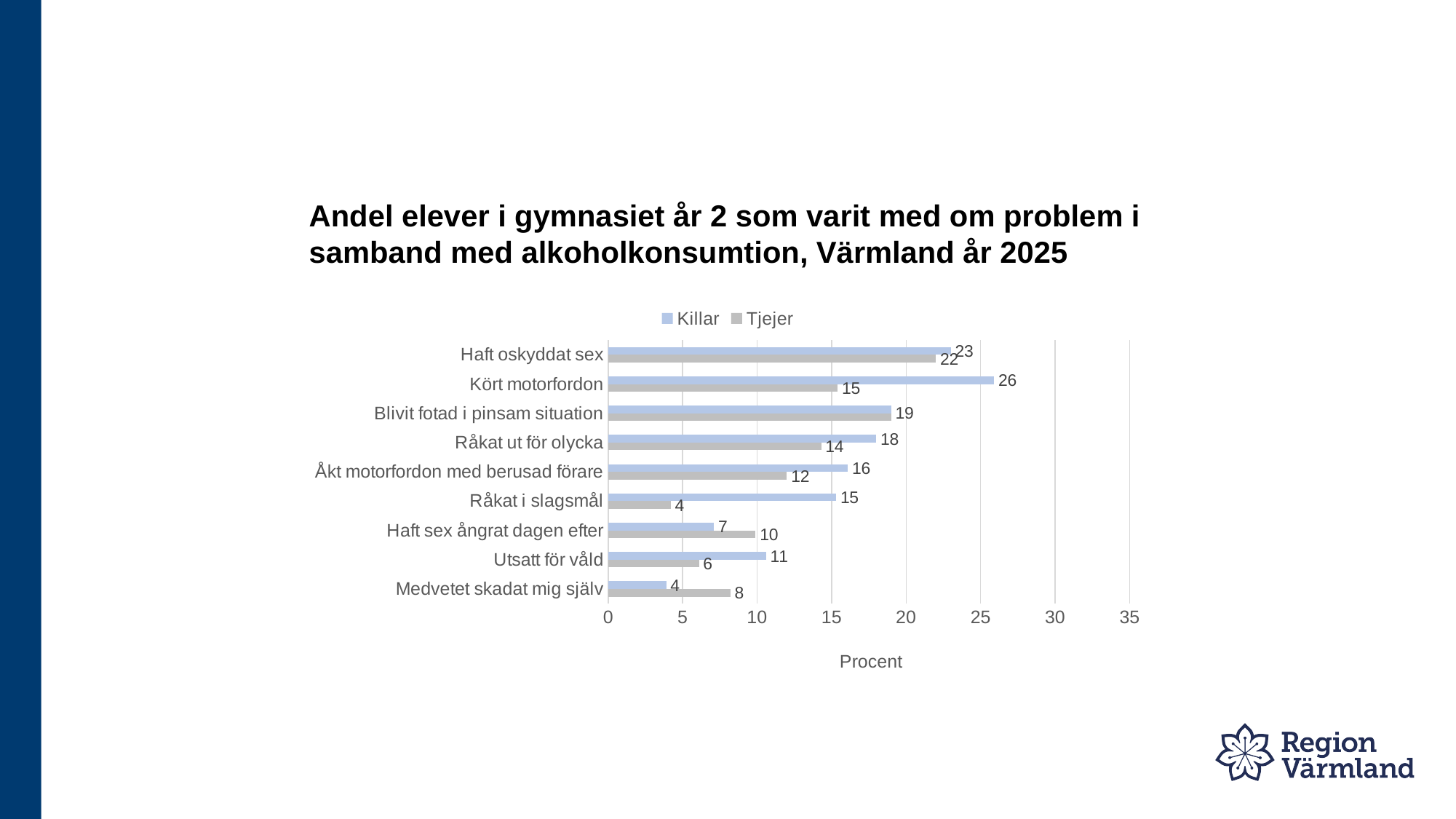
What is the label of the horizontal axis? Procent Which category has the lowest value for Killar? Medvetet skadat mig själv How many series does the legend list? 2 Which category has the highest value for Tjejer? Haft oskyddat sex How many categories are shown on the chart? 9 What is the value for Tjejer for 'Råkat i slagsmål'? 4 What is the value for Tjejer for 'Haft oskyddat sex'? 22 For 'Haft sex ångrat dagen efter', which is larger, Killar or Tjejer? Tjejer Which category has the highest value for Killar? Kört motorfordon What kind of chart is shown on the slide? Bar chart What is the difference between Killar and Tjejer for 'Kört motorfordon'? 11 What is the value for Killar for 'Kört motorfordon'? 26